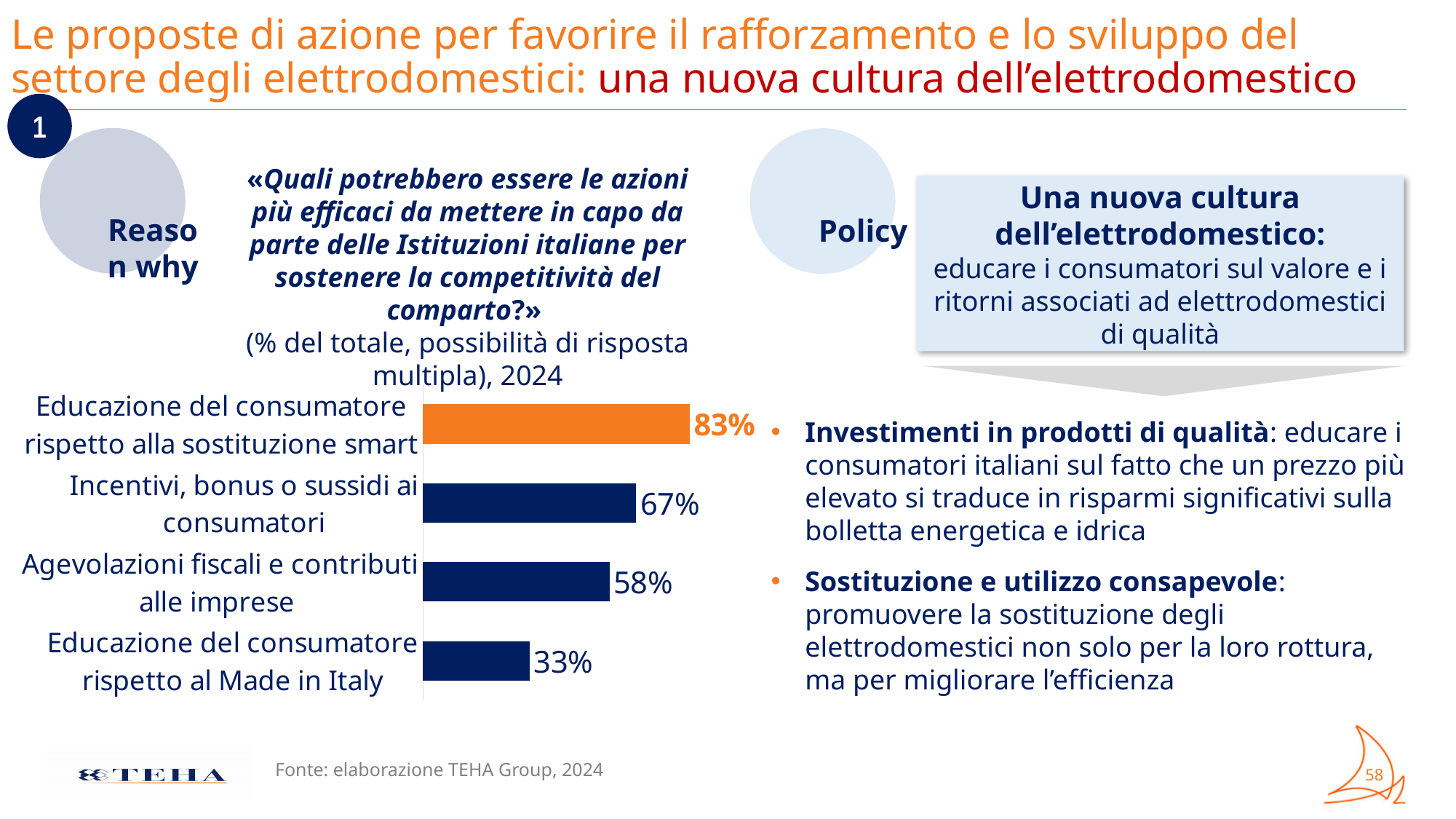
What type of chart is used to show the survey responses? Bar chart What is the difference between the highest and lowest values in the chart? 50 percentage points Which is larger: the value for "Agevolazioni fiscali e contributi alle imprese" or for "Educazione del consumatore rispetto al Made in Italy"? Agevolazioni fiscali e contributi alle imprese What is the value for "Agevolazioni fiscali e contributi alle imprese"? 58% How many categories (actions) are shown in the bar chart? 4 What is the value for "Incentivi, bonus o sussidi ai consumatori"? 67% Which action received the highest share of responses? Educazione del consumatore rispetto alla sostituzione smart What is the value for "Educazione del consumatore rispetto al Made in Italy"? 33% What is the difference in percentage points between "Incentivi, bonus o sussidi ai consumatori" and "Agevolazioni fiscali e contributi alle imprese"? 9 percentage points Which bar in the chart is highlighted in orange? Educazione del consumatore rispetto alla sostituzione smart Which action received the lowest share of responses? Educazione del consumatore rispetto al Made in Italy What percentage of respondents chose "Educazione del consumatore rispetto alla sostituzione smart"? 83%